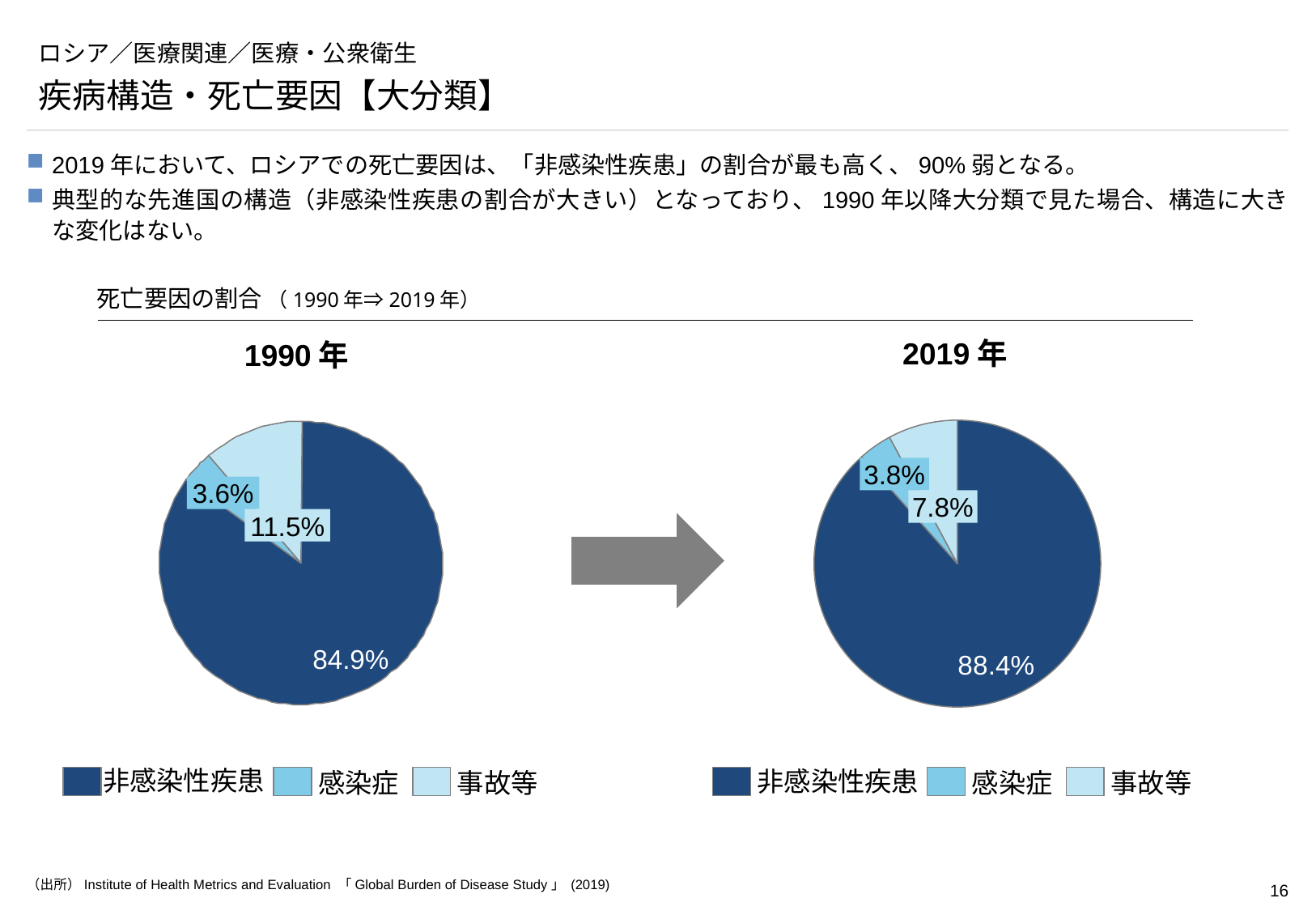
How many categories does the 2019年 pie chart show? 3 Which is larger: the 事故等 share in the 1990年 chart or in the 2019年 chart? 1990年 In the 2019年 pie chart, what share is shown for 非感染性疾患? 88.4% In the 1990年 pie chart, which category has the largest share? 非感染性疾患 In the 1990年 pie chart, what share is shown for 非感染性疾患? 84.9% In the 1990年 pie chart, what is the difference between the 事故等 share and the 感染症 share? 7.9% In the 2019年 pie chart, which category has the smallest share? 感染症 In the 1990年 pie chart, what share is shown for 感染症? 3.6% What type of chart is used for the 1990年 data? Pie chart In the 2019年 pie chart, what share is shown for 事故等? 7.8% What are the three legend entries shown under the 1990年 pie chart? 非感染性疾患, 感染症, 事故等 What is the difference between the 非感染性疾患 share in the 2019年 chart and in the 1990年 chart? 3.5%